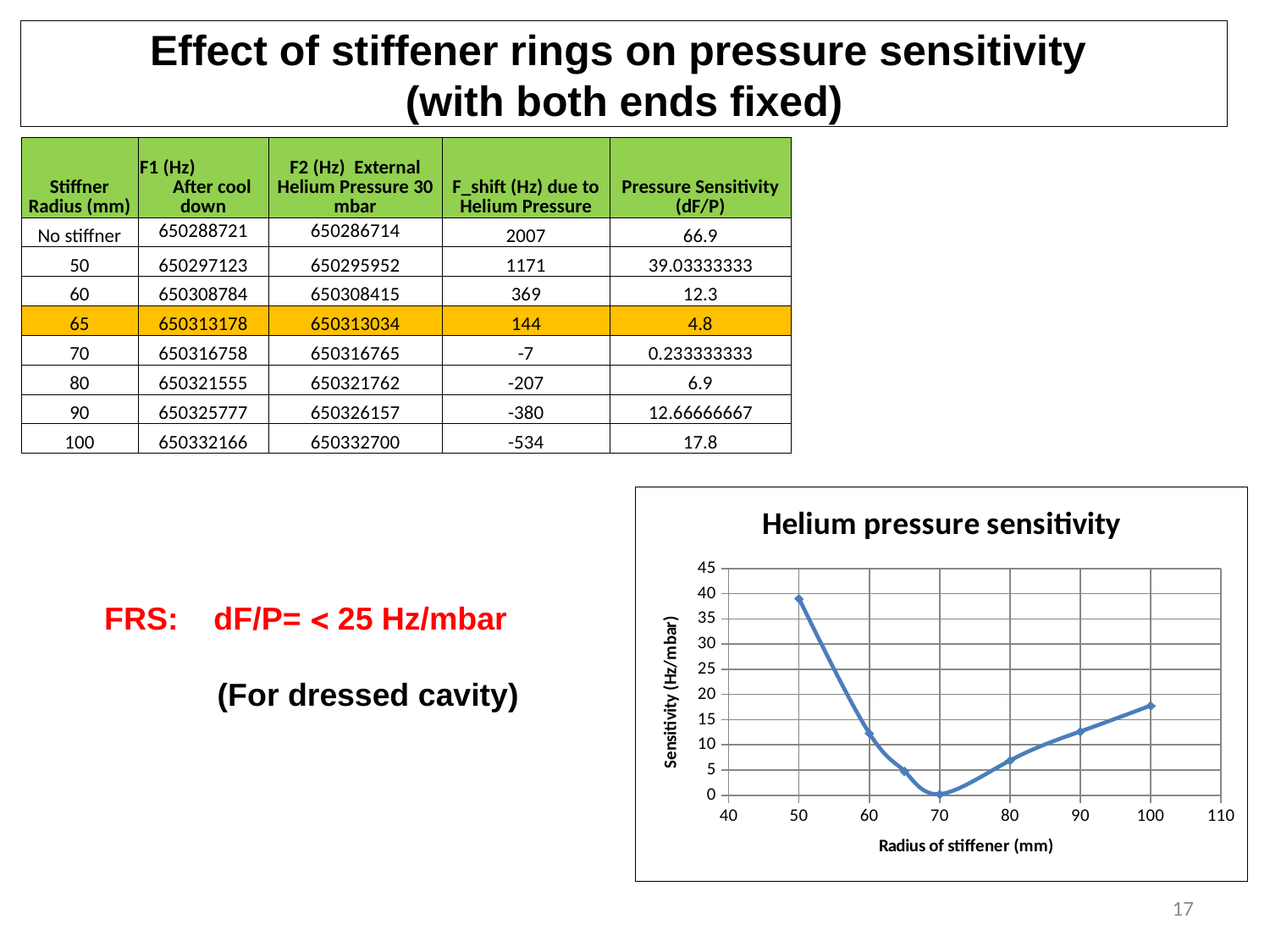
How many data points are plotted on the Helium pressure sensitivity chart? 7 On the Helium pressure sensitivity chart, is the sensitivity at a radius of 50 mm greater or less than 35? greater On the Helium pressure sensitivity chart, is the sensitivity at a radius of 60 mm greater or less than 10? greater On the Helium pressure sensitivity chart, is the sensitivity at a radius of 70 mm greater or less than 5? less What is the title of the chart on the slide? Helium pressure sensitivity What kind of chart is the Helium pressure sensitivity chart? line chart What is the label of the x axis of the Helium pressure sensitivity chart? Radius of stiffener (mm) At which stiffener radius is the sensitivity lowest on the Helium pressure sensitivity chart? 70 On the Helium pressure sensitivity chart, does the sensitivity rise or fall as the radius increases from 50 mm to 70 mm? fall At which stiffener radius is the sensitivity highest on the Helium pressure sensitivity chart? 50 On the Helium pressure sensitivity chart, which has the higher sensitivity: a radius of 50 mm or a radius of 100 mm? 50 mm